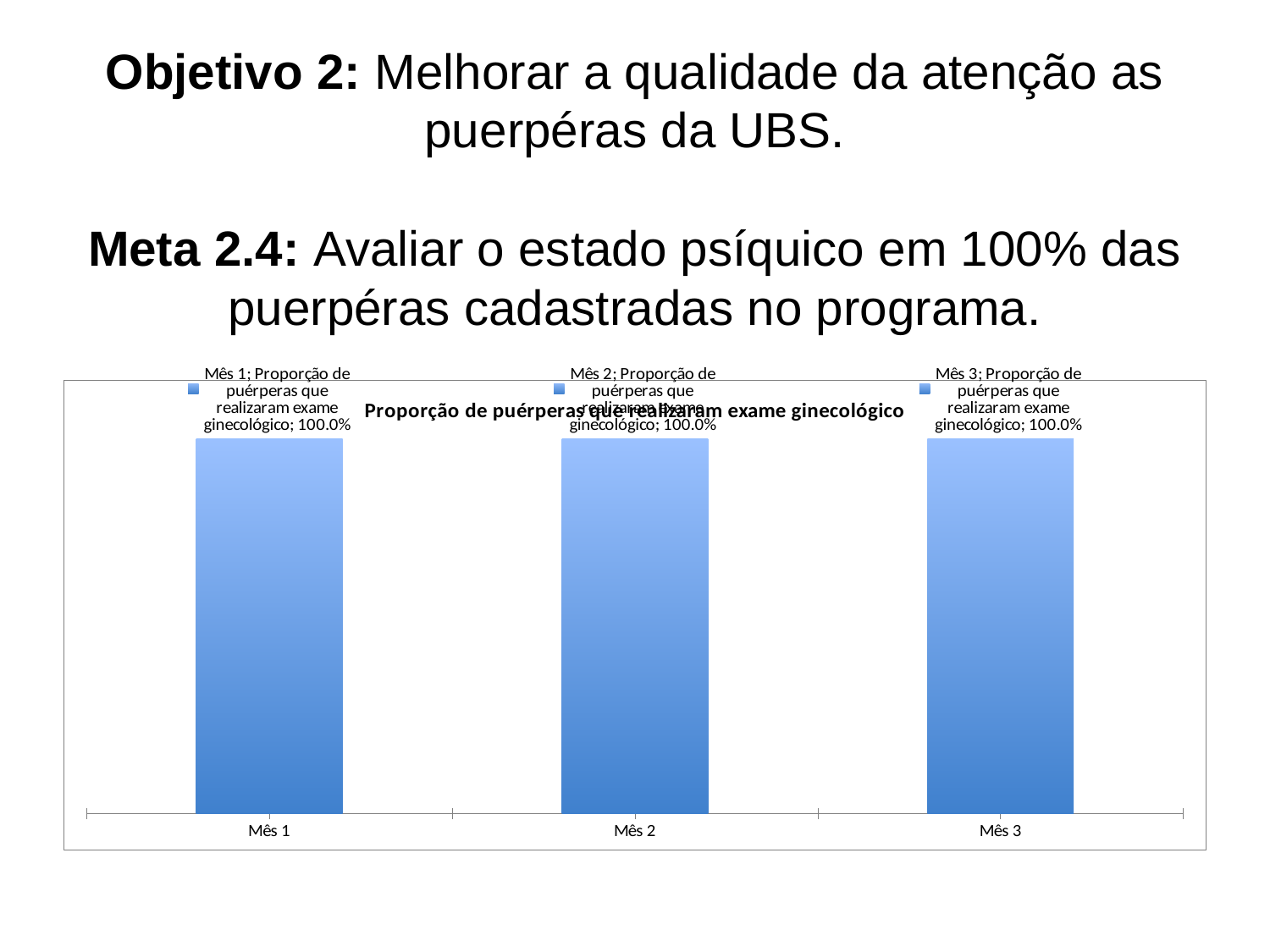
What is the difference between the values for Mês 2 and Mês 1? 0.0% How many categories (months) are plotted in the chart? 3 Do the values rise, fall or stay the same from Mês 1 to Mês 3? Stay the same What is the value for Mês 1 in the chart? 100.0% What kind of chart is shown on the slide? Bar chart What is the title of the chart? Proporção de puérperas que realizaram exame ginecológico What is the value for Mês 3 in the chart? 100.0% What is the label of the first category on the x axis? Mês 1 What is the value for Mês 2 in the chart? 100.0% What is the difference between the values for Mês 3 and Mês 1? 0.0%